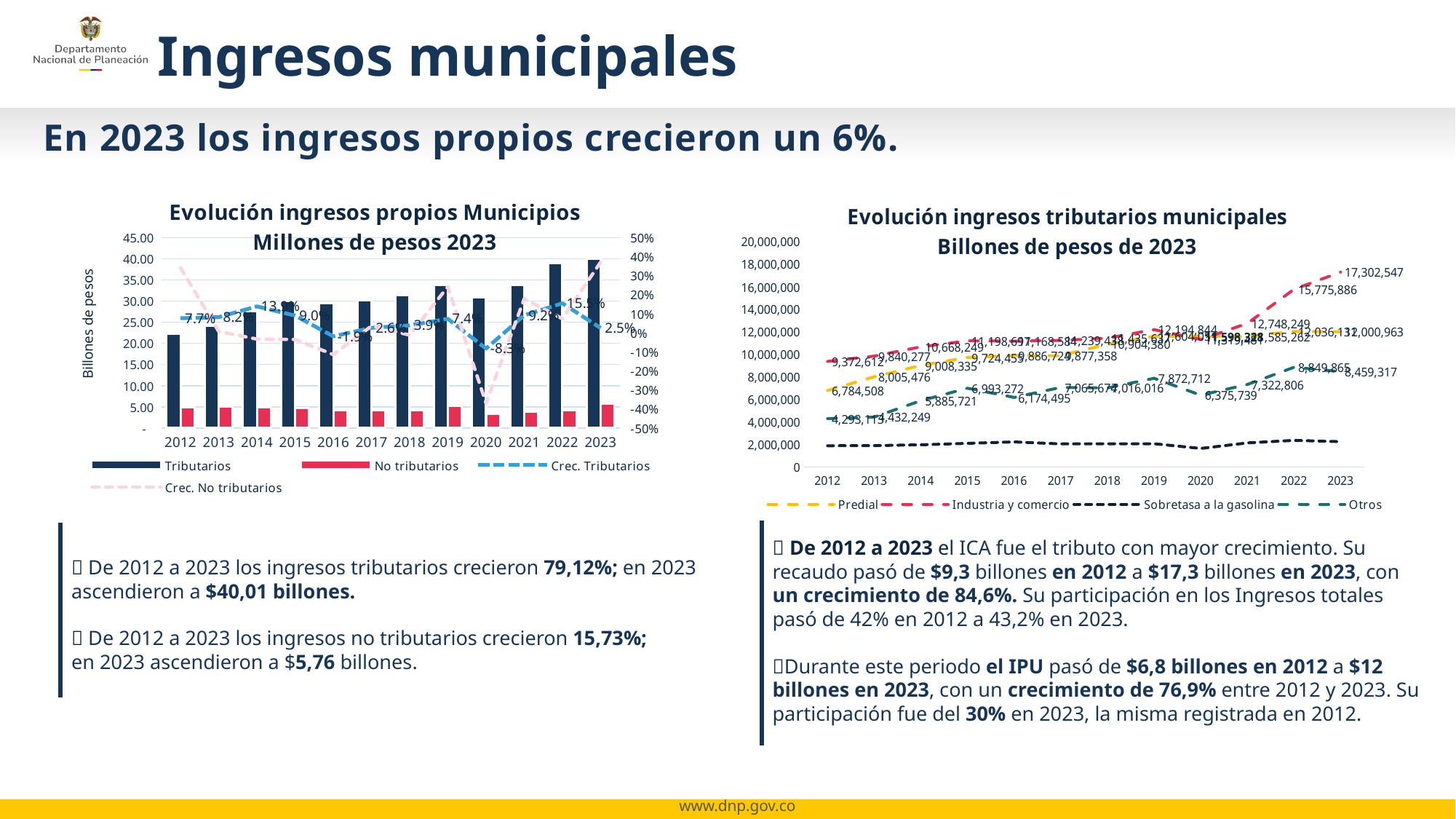
In the 'Evolución ingresos tributarios municipales' chart on the right, what is the value for Industria y comercio in 2023? 17,302,547 In the 'Evolución ingresos tributarios municipales' chart on the right, what is the value for Otros in 2012? 4,293,113 How many series does the legend of the 'Evolución ingresos propios Municipios' chart on the left list? 4 In the 'Evolución ingresos tributarios municipales' chart on the right, by how much did Industria y comercio increase from 2012 (9,372,612) to 2023 (17,302,547)? 7,929,935 In the 'Evolución ingresos tributarios municipales' chart on the right, what is the value for Predial in 2012? 6,784,508 In the 'Evolución ingresos tributarios municipales' chart on the right, which series has the lowest values across all years? Sobretasa a la gasolina What kind of chart is the 'Evolución ingresos tributarios municipales' chart on the right? line chart In the 'Evolución ingresos tributarios municipales' chart on the right, is the value for Otros larger in 2022 or in 2023? 2022 In the 'Evolución ingresos tributarios municipales' chart on the right, which series has the highest value in 2023? Industria y comercio In the 'Evolución ingresos propios Municipios' chart on the left, what is the Crec. Tributarios value for 2020? -8.3% How many years are shown on the x axis of the 'Evolución ingresos propios Municipios' chart on the left? 12 In the 'Evolución ingresos propios Municipios' chart on the left, is the Tributarios bar for 2023 greater or less than 35.00? greater